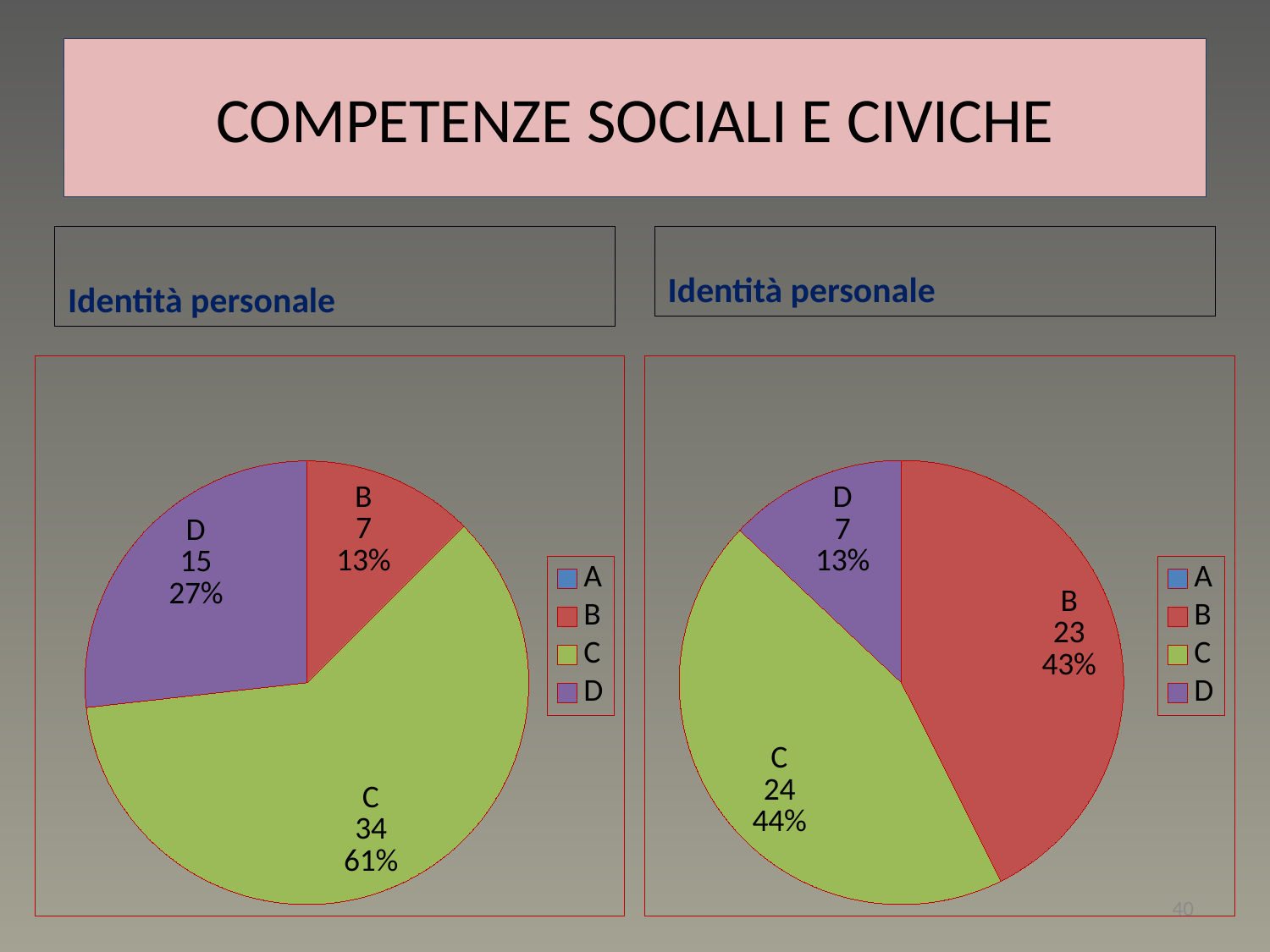
In the left pie chart, which category has the largest slice? C In the left pie chart, which is larger, the value for D or the value for B? D In the left pie chart, what is the difference between the values for C and D? 19 In the left pie chart, which category has the smallest slice? B In the right pie chart, what value is shown for category B? 23 In the right pie chart, what is the difference between the values for C and B? 1 In the left pie chart, what percentage is shown for category D? 27% How many entries does the legend of the right pie chart list? 4 In the right pie chart, which category has the smallest slice? D In the left pie chart, what value is shown for category C? 34 In the right pie chart, what percentage is shown for category C? 44% What type of chart is shown on the left side of the slide? Pie chart